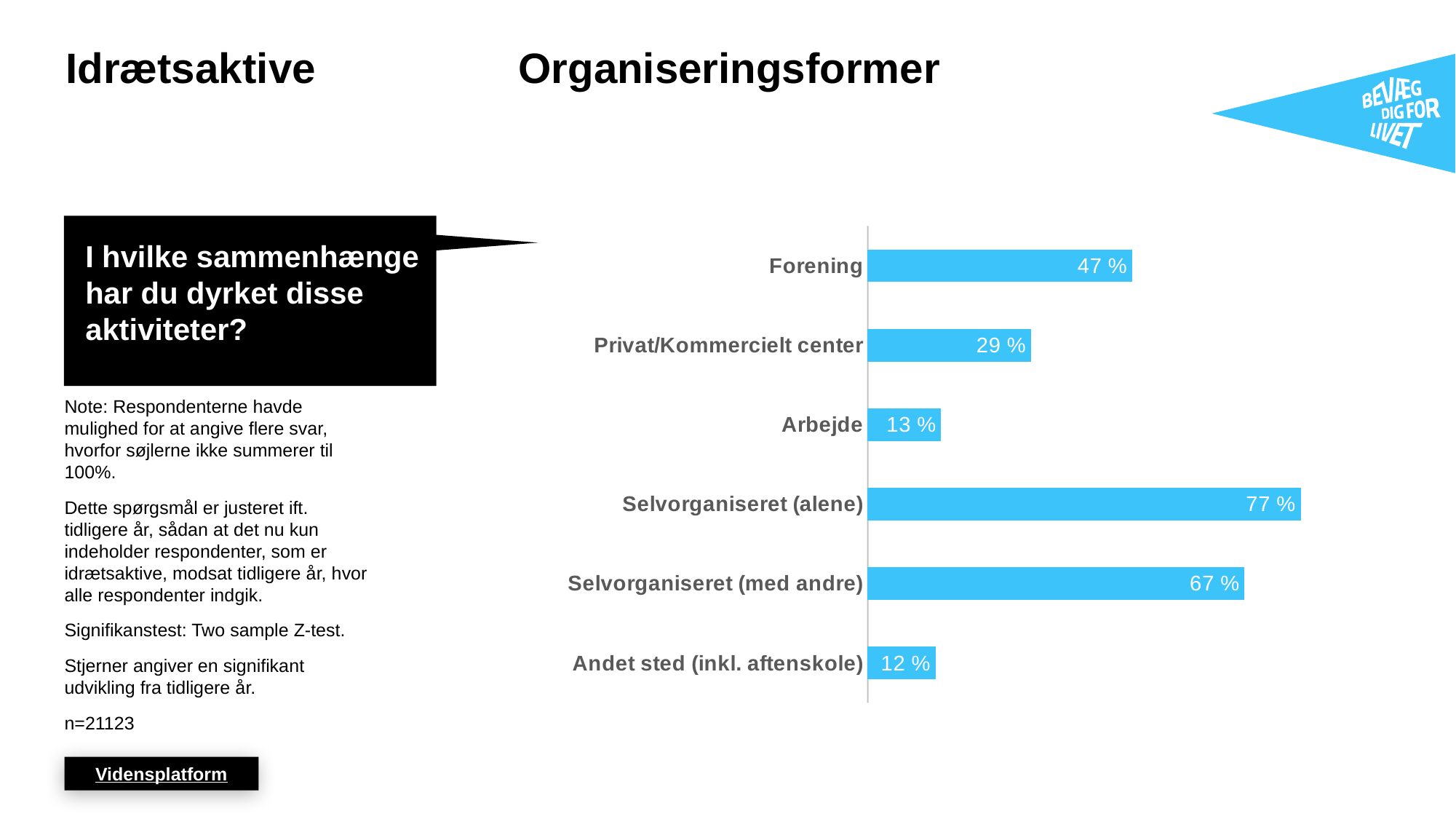
What is the value for Privat/Kommercielt center? 29 % What is the value for Arbejde? 13 % Which category has the lowest value? Andet sted (inkl. aftenskole) What question does the chart answer, according to the black box on the slide? I hvilke sammenhænge har du dyrket disse aktiviteter? Which category has the highest value? Selvorganiseret (alene) What is the difference between Selvorganiseret (alene) and Selvorganiseret (med andre)? 10 % What is the value for Forening? 47 % What is the difference between Forening and Privat/Kommercielt center? 18 % What kind of chart is shown on the slide? Bar chart What is the value for Selvorganiseret (med andre)? 67 % Which is larger, Forening or Privat/Kommercielt center? Forening How many categories are shown in the chart? 6